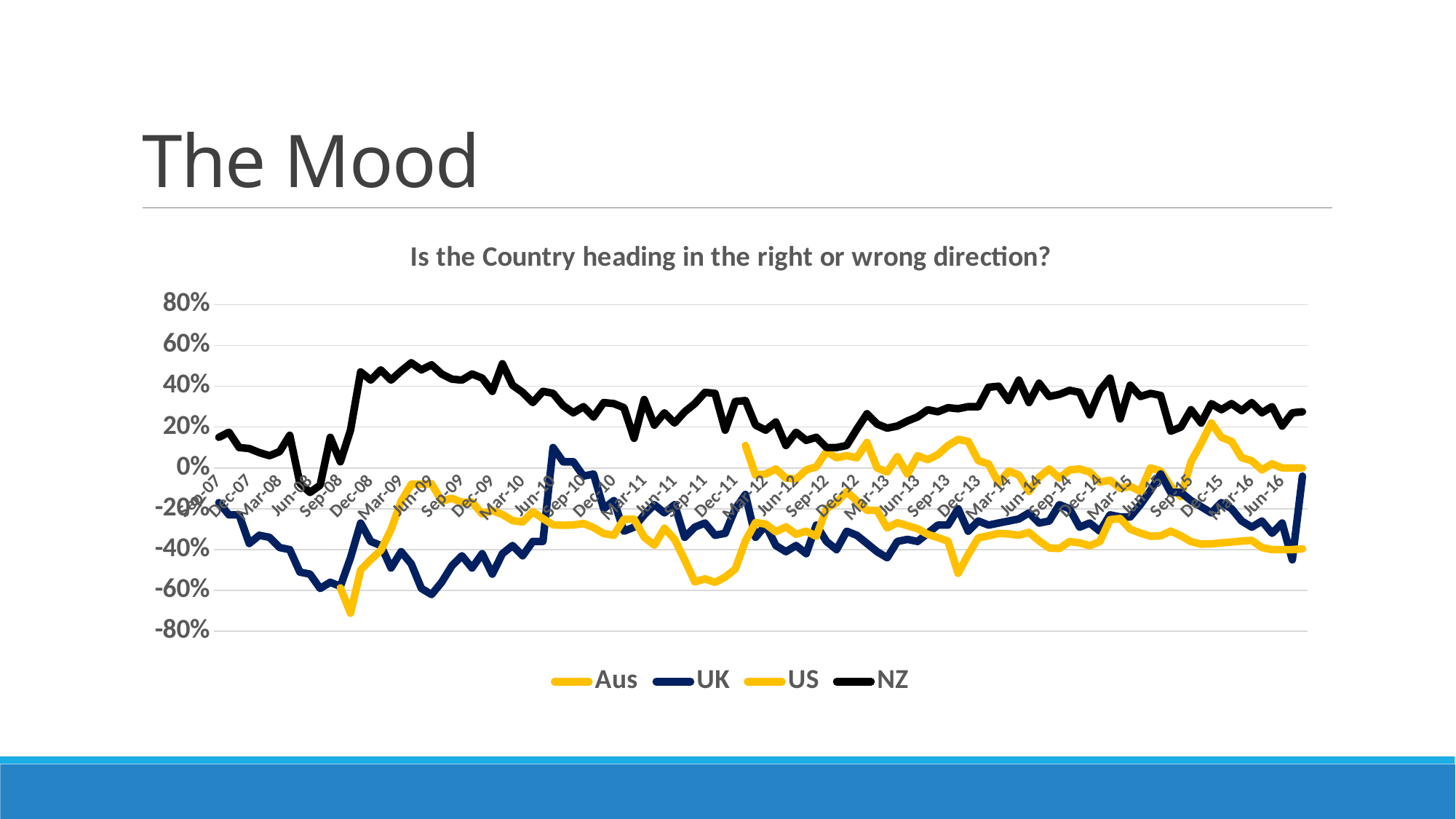
Which series has the highest values across most of the chart? NZ How many series does the legend list? 4 Is the value for NZ at Dec-08 greater or less than 20%? greater Is the value for NZ at Jun-09 greater or less than 40%? greater Is the value for UK at Sep-08 greater or less than -40%? less Which series is drawn in black? NZ What is the highest value shown on the vertical axis? 80% What is the title of the chart? Is the Country heading in the right or wrong direction? Does the NZ line rise or fall between Sep-08 and Dec-08? Rise What kind of chart is shown on the slide? Line chart Which is larger at Dec-08, the value for NZ or the value for UK? NZ Does the UK line rise or fall between Dec-07 and Sep-08? Fall